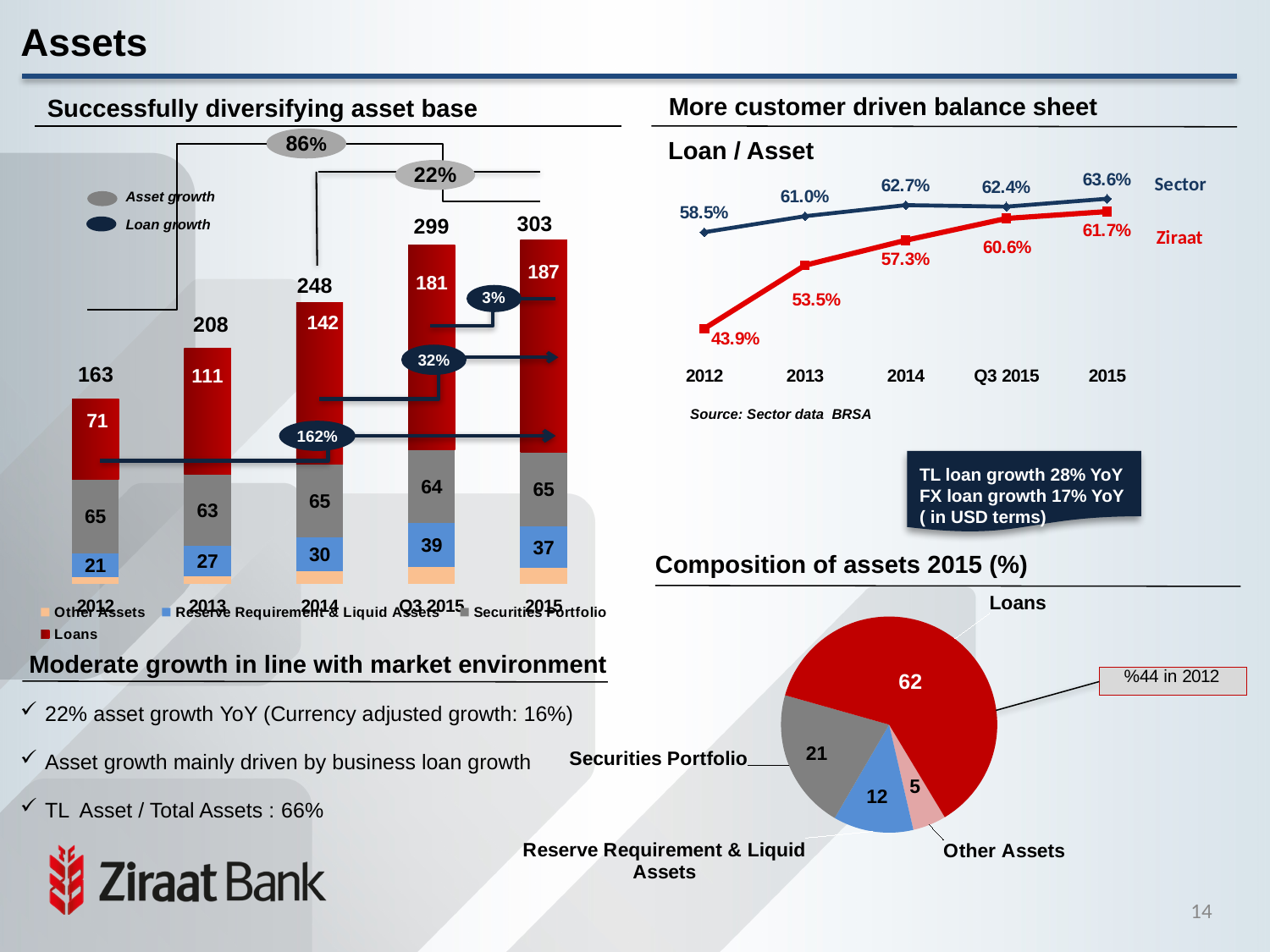
In the Composition of assets 2015 (%) pie chart, what is the share for Securities Portfolio? 21 In the stacked bar chart on the left, what is the difference between the Loans values for 2015 and 2012? 116 In the stacked bar chart on the left, what is the Loans value for 2014? 142 In the Loan / Asset chart, what is the Sector value for 2015? 63.6% In the Loan / Asset chart, what is the Ziraat value for 2013? 53.5% In the stacked bar chart on the left, what is the total for 2015? 303 In the stacked bar chart on the left, how many series does the legend list? 4 In the Composition of assets 2015 (%) pie chart, which slice is the largest? Loans In the Loan / Asset chart, what kind of chart is shown? line chart In the stacked bar chart on the left, what is the Reserve Requirement & Liquid Assets value for Q3 2015? 39 In the Loan / Asset chart, do the Ziraat values rise or fall from 2012 to 2015? rise In the Loan / Asset chart, which year has the lowest Ziraat value? 2012